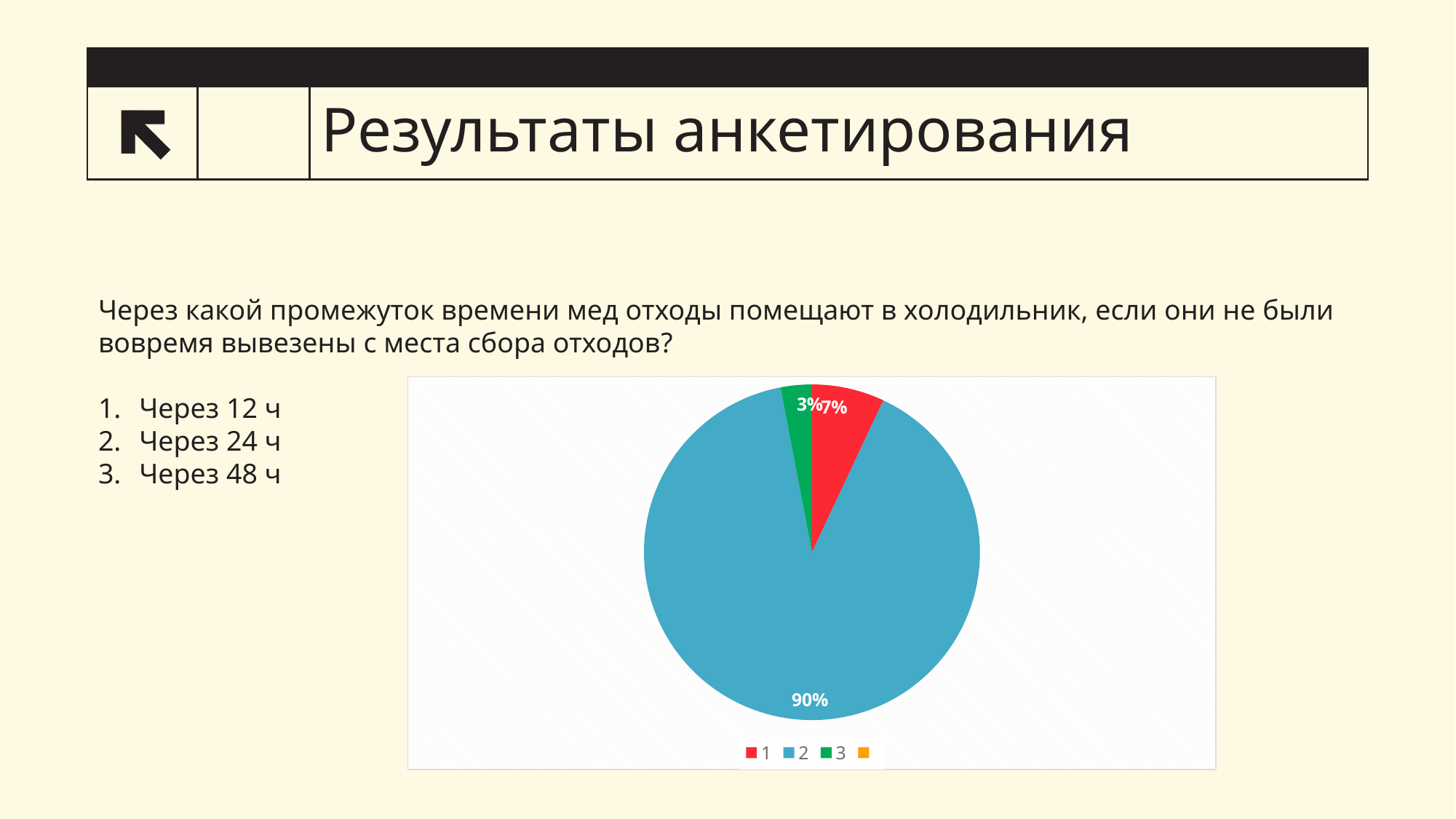
Which labelled slice of the pie is the smallest? 3 What type of chart is shown on the slide? pie chart What is the difference in percentage points between slice 2 and slice 1? 83 What percentage of the pie does slice 2 represent? 90% What colour is the slice for category 1 in the legend? red Which slice of the pie is the largest? 2 What colour is the slice labelled 90%? blue How many slices are visible in the pie chart? 3 Which is larger, slice 1 or slice 3? 1 What percentage of the pie does slice 3 represent? 3% What percentage of the pie does slice 1 represent? 7% What is the difference in percentage points between slice 1 and slice 3? 4